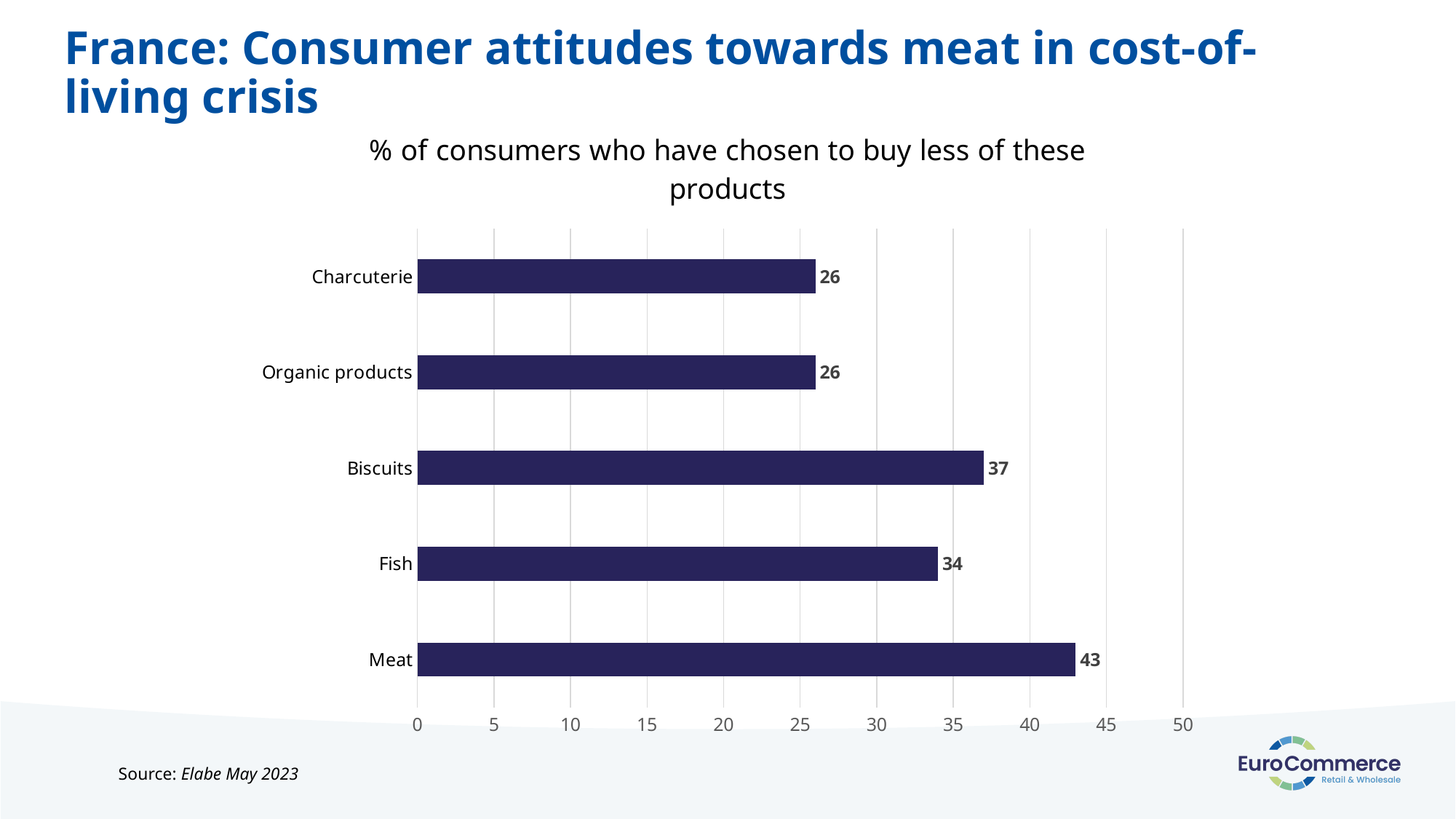
What is the value for Meat? 43 What is the value for Fish? 34 What kind of chart is shown on the slide? Bar chart What is the difference between the values for Meat and Fish? 9 Is the value for Meat greater or less than 40? greater How many categories are shown in the chart? 5 Which category has the highest value? Meat What is the difference between the values for Biscuits and Charcuterie? 11 What is the value for Biscuits? 37 Which is larger, the value for Biscuits or the value for Fish? Biscuits What is the title of the chart? % of consumers who have chosen to buy less of these products What is the value for Organic products? 26